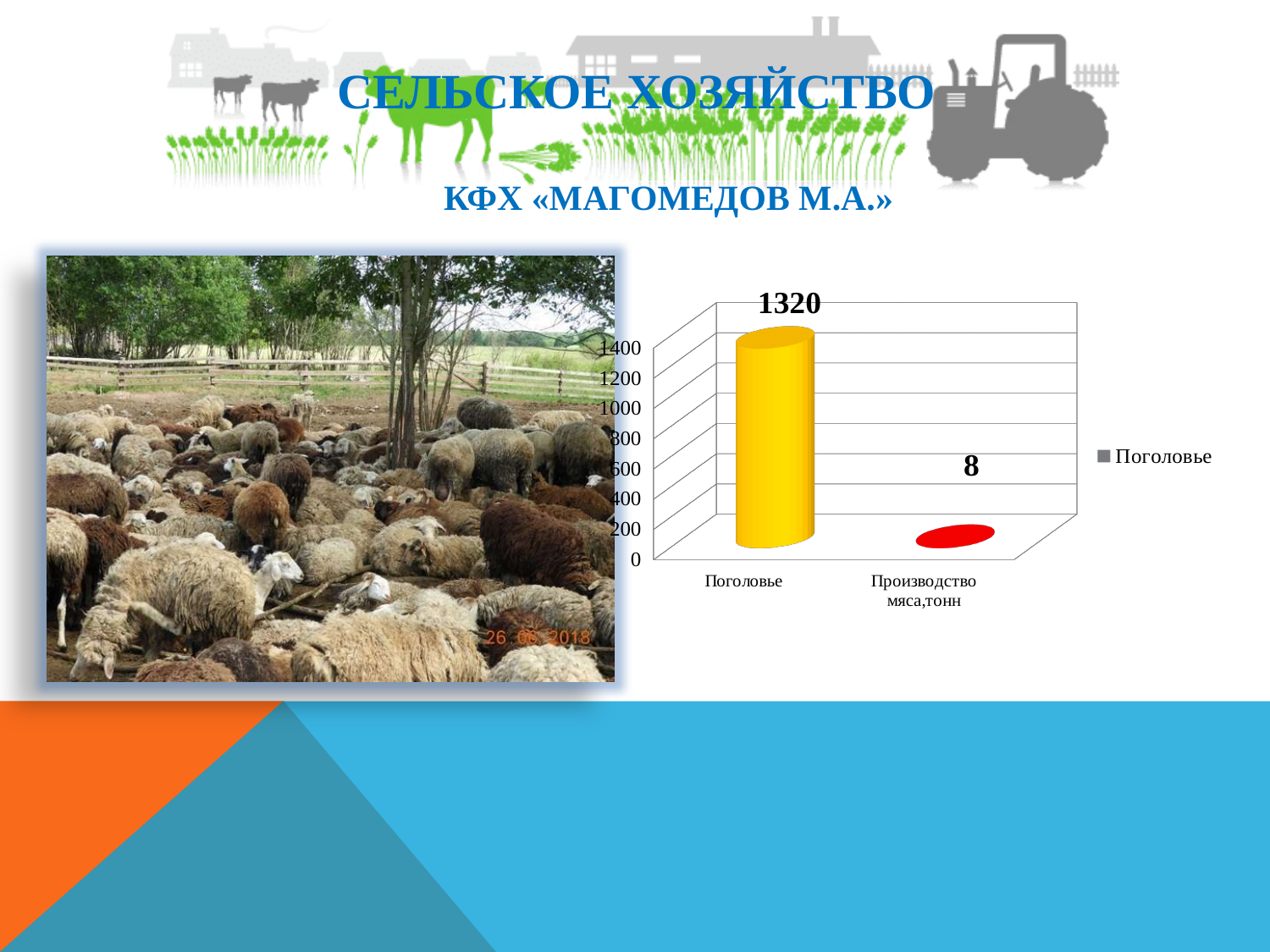
Is the value for Поголовье greater or less than 1000? greater Which category has the lowest value? Производство мяса,тонн What is the legend entry shown on the chart? Поголовье Is the value for Производство мяса,тонн greater or less than 200? less What is the value for Производство мяса,тонн? 8 What kind of chart is shown on the slide? bar chart How many categories are shown on the x axis of the chart? 2 Which is larger, the value for Поголовье or the value for Производство мяса,тонн? Поголовье What is the value for Поголовье? 1320 What is the difference between the values for Поголовье and Производство мяса,тонн? 1312 How many series does the legend list? 1 Which category has the highest value? Поголовье